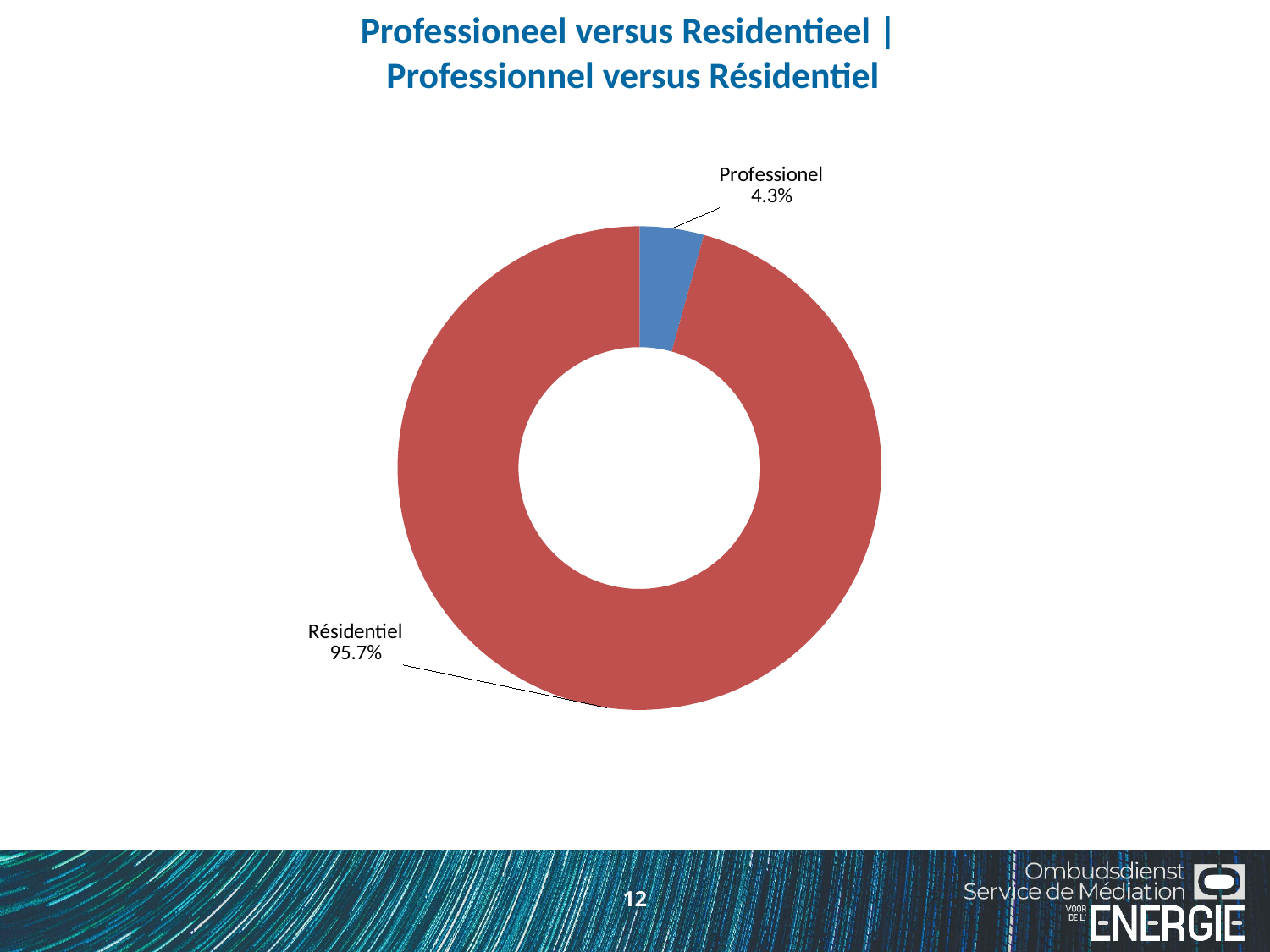
What share of the chart does the Professionel slice represent? 4.3% What share of the chart does the Résidentiel slice represent? 95.7% What colour is the Résidentiel slice? Red What kind of chart is shown on the slide? Pie chart (doughnut) Which category has the largest share? Résidentiel How many categories are shown in the chart? 2 Is the Professionel share greater or less than 10%? less What is the title of the chart? Professioneel versus Residentieel | Professionnel versus Résidentiel Which category has the smallest share? Professionel What is the total of the two shares shown? 100% Which is larger, the Professionel share or the Résidentiel share? Résidentiel What is the difference in percentage points between the Résidentiel and Professionel shares? 91.4